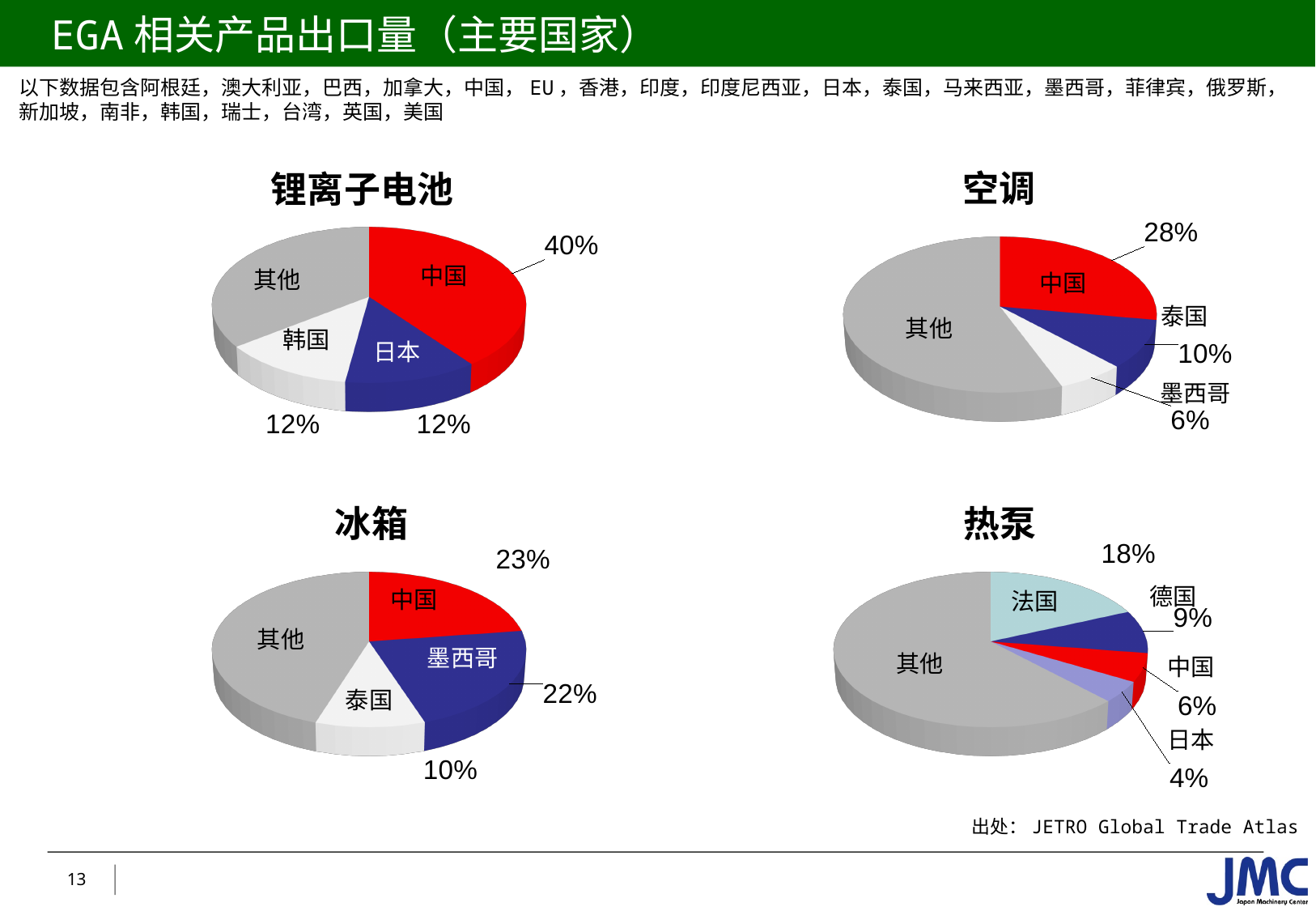
In the 冰箱 chart, which is larger, 中国 or 墨西哥? 中国 In the 冰箱 chart, what is the value for 泰国? 10% In the 空调 chart, what share does 墨西哥 hold? 6% In the 热泵 chart, which labeled country has the smallest share? 日本 In the 锂离子电池 chart, what is the difference between 中国 and 韩国? 28 percentage points In the 空调 chart, what is the value for 泰国? 10% How many slices does the 热泵 pie chart have? 5 In the 锂离子电池 chart, what is the value for 日本? 12% In the 热泵 chart, what is the difference between 法国 and 德国? 9 percentage points In the 锂离子电池 chart, what share does 中国 hold? 40% What kind of chart is used for 锂离子电池? pie chart In the 空调 chart, which labeled country has the largest share? 中国